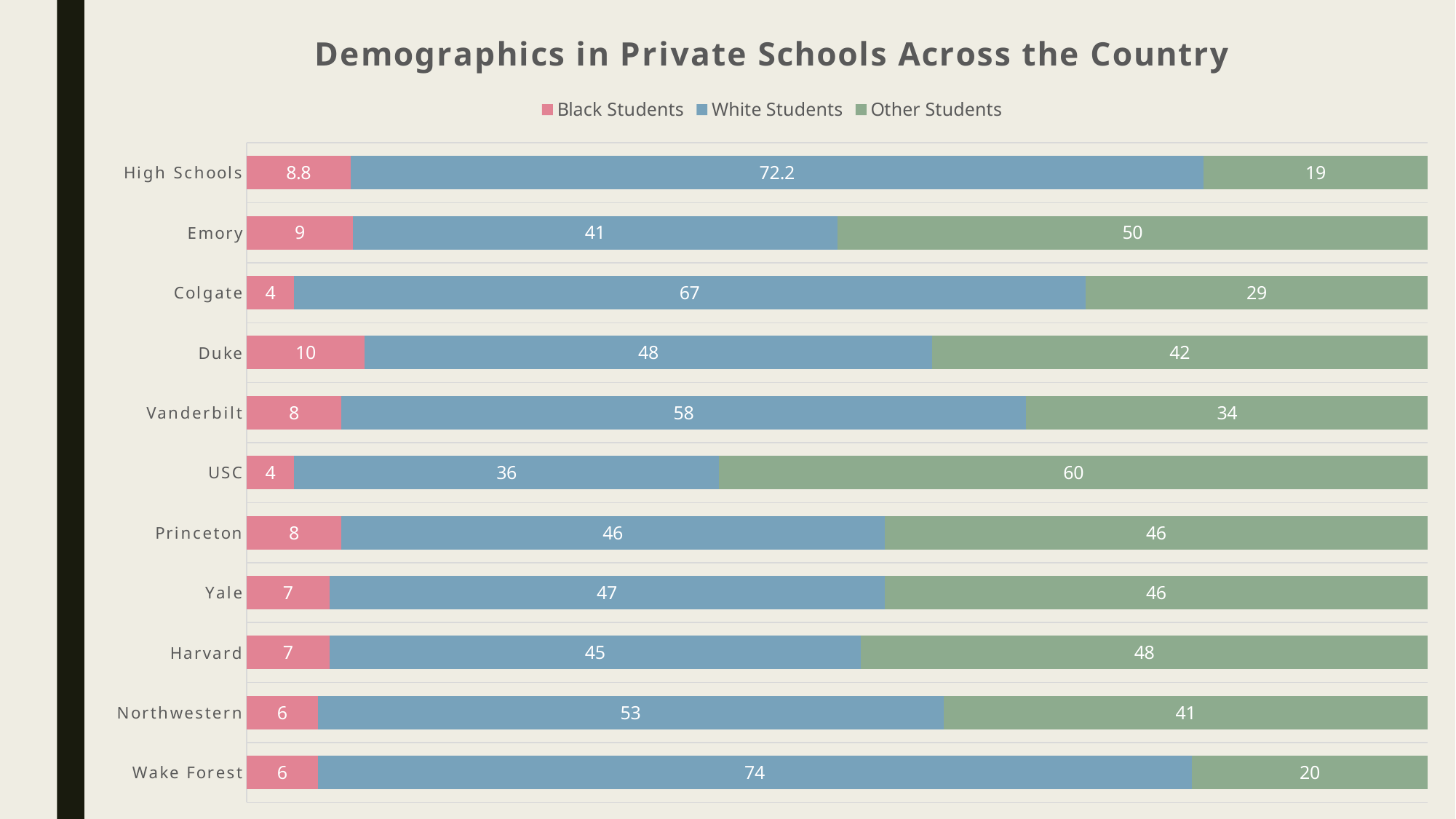
What is the difference between the White Students and Other Students values at Wake Forest? 54 What is the value for Black Students for High Schools? 8.8 Which category has the highest value for Black Students? Duke How many series does the legend list? 3 Which category has the highest value for White Students? Wake Forest What is the total of the stacked bar for Duke? 100 Which is larger at Emory: the White Students value or the Other Students value? Other Students Which category has the lowest value for White Students? USC How many categories are shown on the chart? 11 What kind of chart is shown on the slide? Stacked bar chart What is the value for White Students at Wake Forest? 74 What is the value for Other Students at Emory? 50